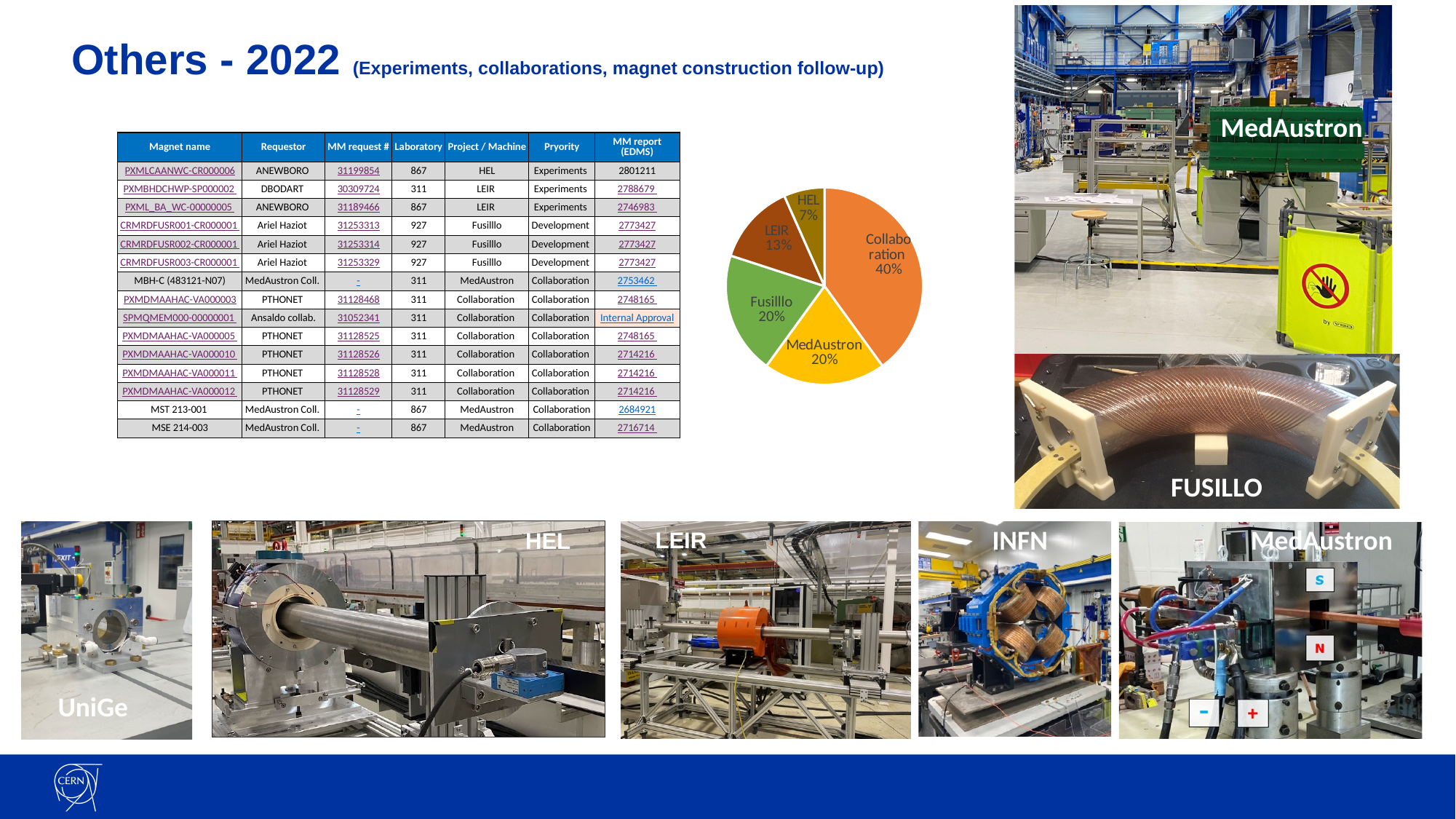
What percentage is shown for the Fusillo slice of the pie chart? 20% Which slice of the pie chart is the smallest? HEL What share of the pie chart does the Collaboration slice represent? 40% Which slice of the pie chart is the largest? Collaboration What percentage is shown for the HEL slice of the pie chart? 7% What is the difference in percentage points between the Collaboration slice and the LEIR slice in the pie chart? 27 What percentage is shown for the MedAustron slice of the pie chart? 20% What is the difference in percentage points between the LEIR slice and the HEL slice in the pie chart? 6 What percentage is shown for the LEIR slice of the pie chart? 13% Which is larger in the pie chart, the LEIR slice or the HEL slice? LEIR What kind of chart is shown on the slide? pie chart How many slices does the pie chart have? 5